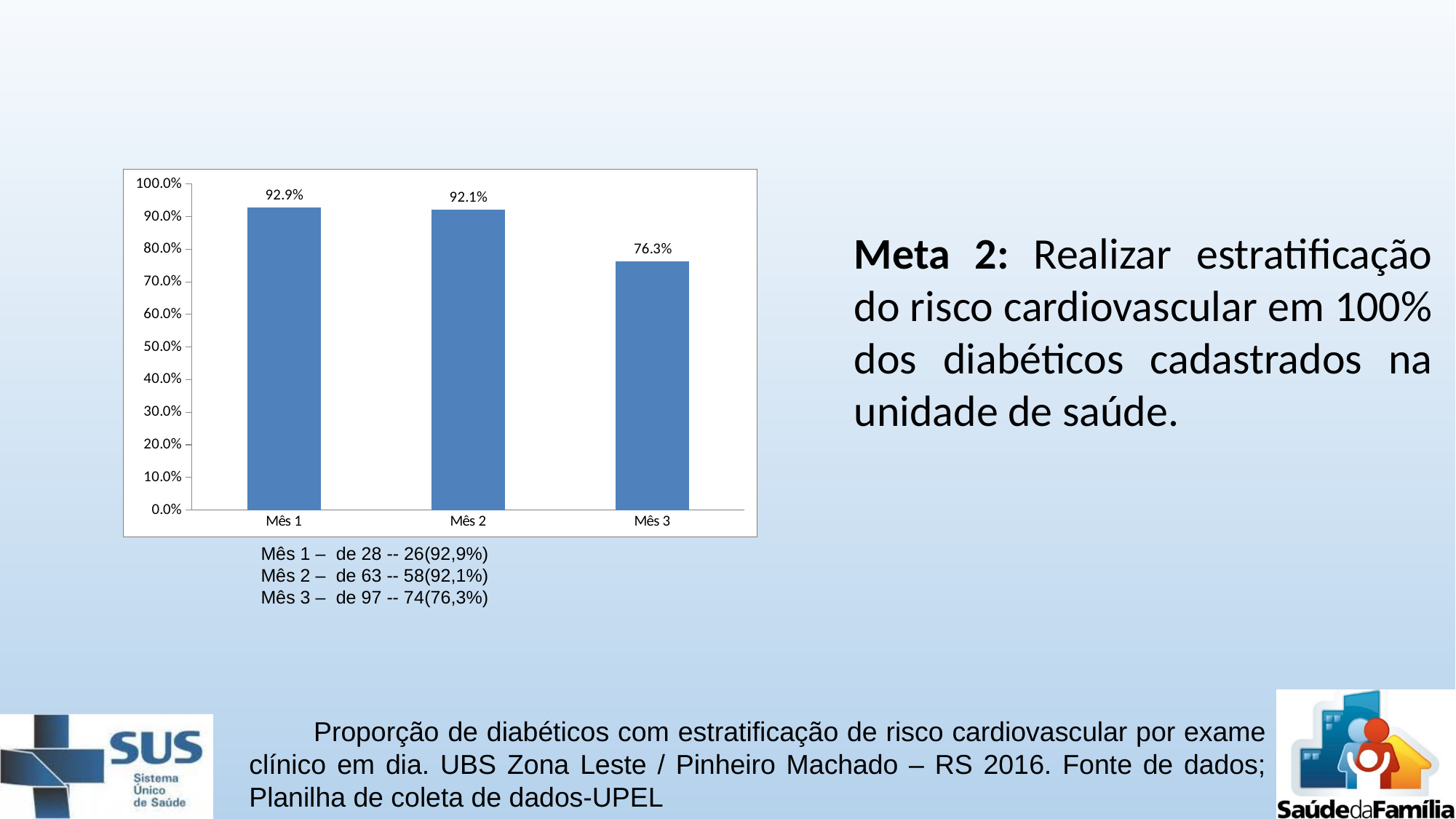
Is the value for Mês 3 greater or less than 80.0%? less What is the value for Mês 3? 76.3% Which month has the highest value? Mês 1 Which month has the lowest value? Mês 3 What is the value for Mês 1? 92.9% How many months are shown on the x axis? 3 Which is larger, the value for Mês 2 or the value for Mês 3? Mês 2 What is the difference between the values for Mês 2 and Mês 3? 15.8% What is the difference between the values for Mês 1 and Mês 3? 16.6% What kind of chart is shown on the slide? bar chart What is the value for Mês 2? 92.1% Do the values rise or fall from Mês 1 to Mês 3? fall